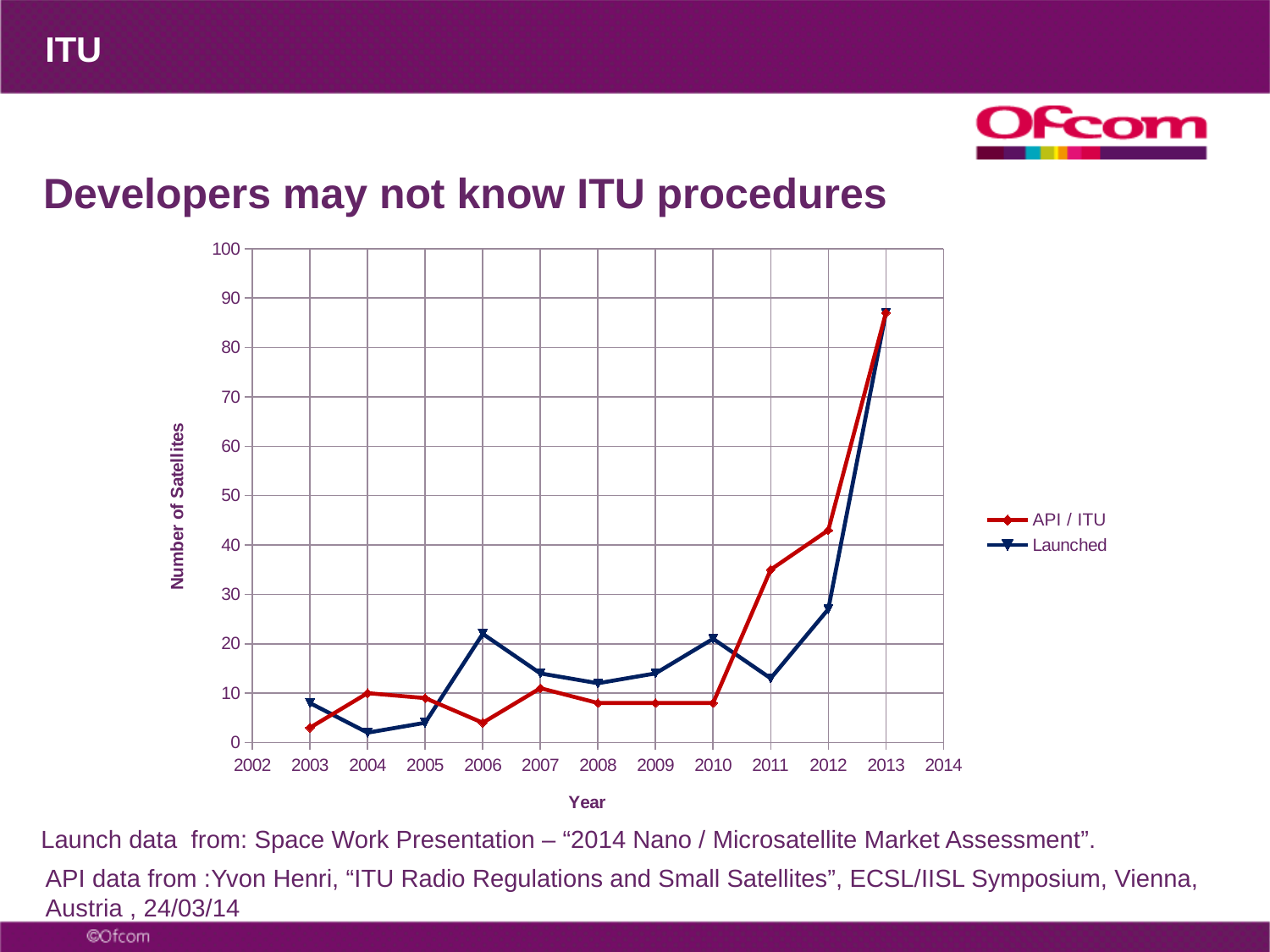
How many years have data points plotted for the API / ITU series? 11 In 2010, which series has the larger value, API / ITU or Launched? Launched In 2012, which series has the larger value, API / ITU or Launched? API / ITU Is the value for Launched in 2006 greater or less than 20? greater Is the value for API / ITU in 2013 greater or less than 80? greater How many series does the legend list? 2 What kind of chart is shown on the slide? Line chart Is the value for API / ITU in 2011 greater or less than 30? greater In which year does the Launched series reach its highest value? 2013 Does the API / ITU series rise or fall from 2010 to 2013? Rise In which year does the API / ITU series reach its highest value? 2013